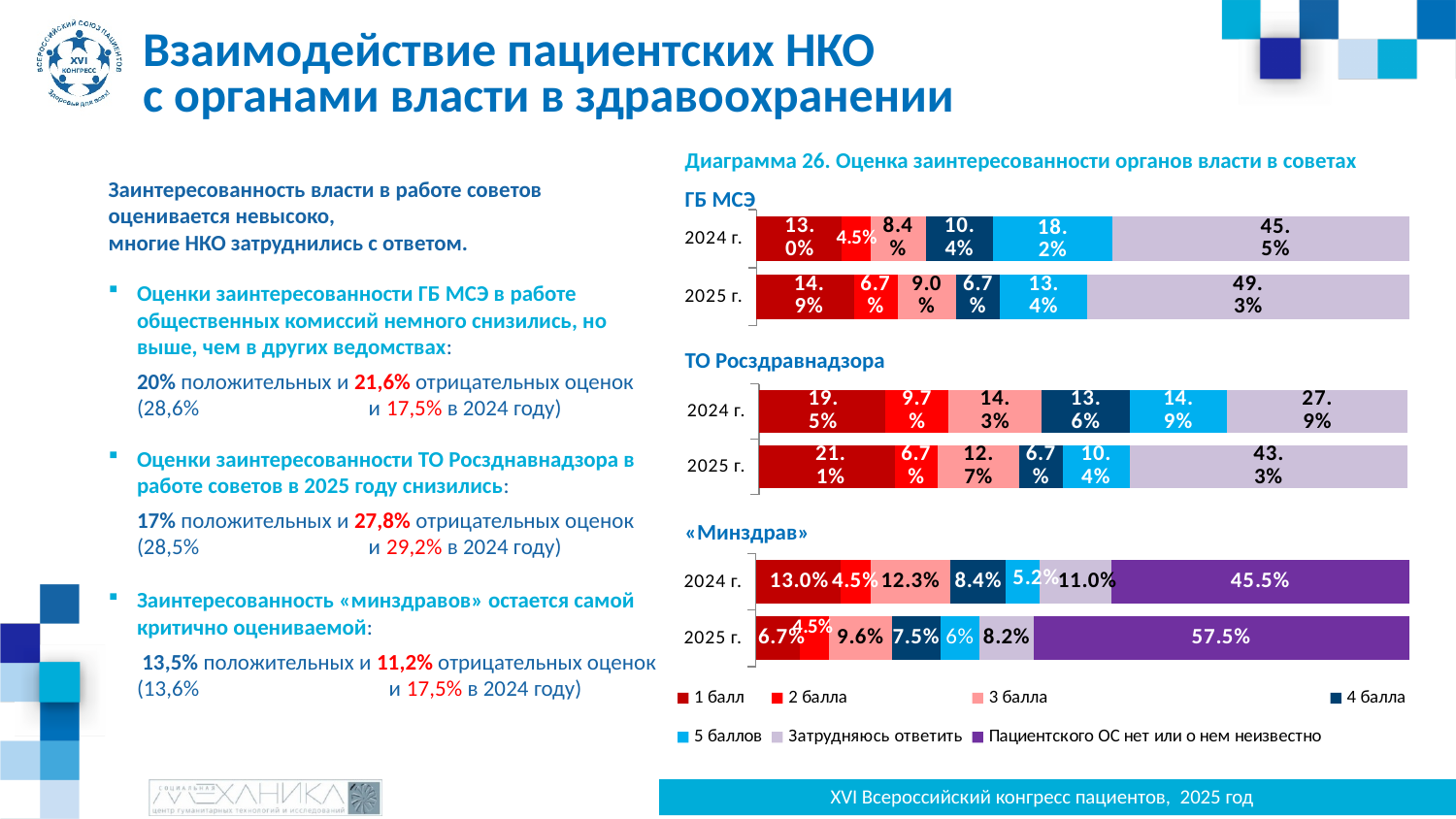
In the ГБ МСЭ chart, what is the value of the 1 балл segment for 2024 г.? 13.0% What type of chart is used for the ГБ МСЭ data? Stacked bar chart In the ТО Росздравнадзора chart, what is the value of the Затрудняюсь ответить segment for 2025 г.? 43.3% How many entries does the legend list? 7 In the «Минздрав» chart, is the Пациентского ОС нет или о нем неизвестно segment larger in 2024 г. or 2025 г.? 2025 г. In the ГБ МСЭ chart, what is the value of the Затрудняюсь ответить segment for 2025 г.? 49.3% In the «Минздрав» chart, what is the value of the 3 балла segment for 2024 г.? 12.3% In the ГБ МСЭ chart, which segment is the largest in the 2024 г. bar? Затрудняюсь ответить In the «Минздрав» chart, what is the value of the Пациентского ОС нет или о нем неизвестно segment for 2025 г.? 57.5% In the ТО Росздравнадзора chart, by how many percentage points did the 1 балл segment change from 2024 г. to 2025 г.? 1.6 percentage points How many bars does the ТО Росздравнадзора chart contain? 2 In the ТО Росздравнадзора chart, what is the value of the 5 баллов segment for 2024 г.? 14.9%